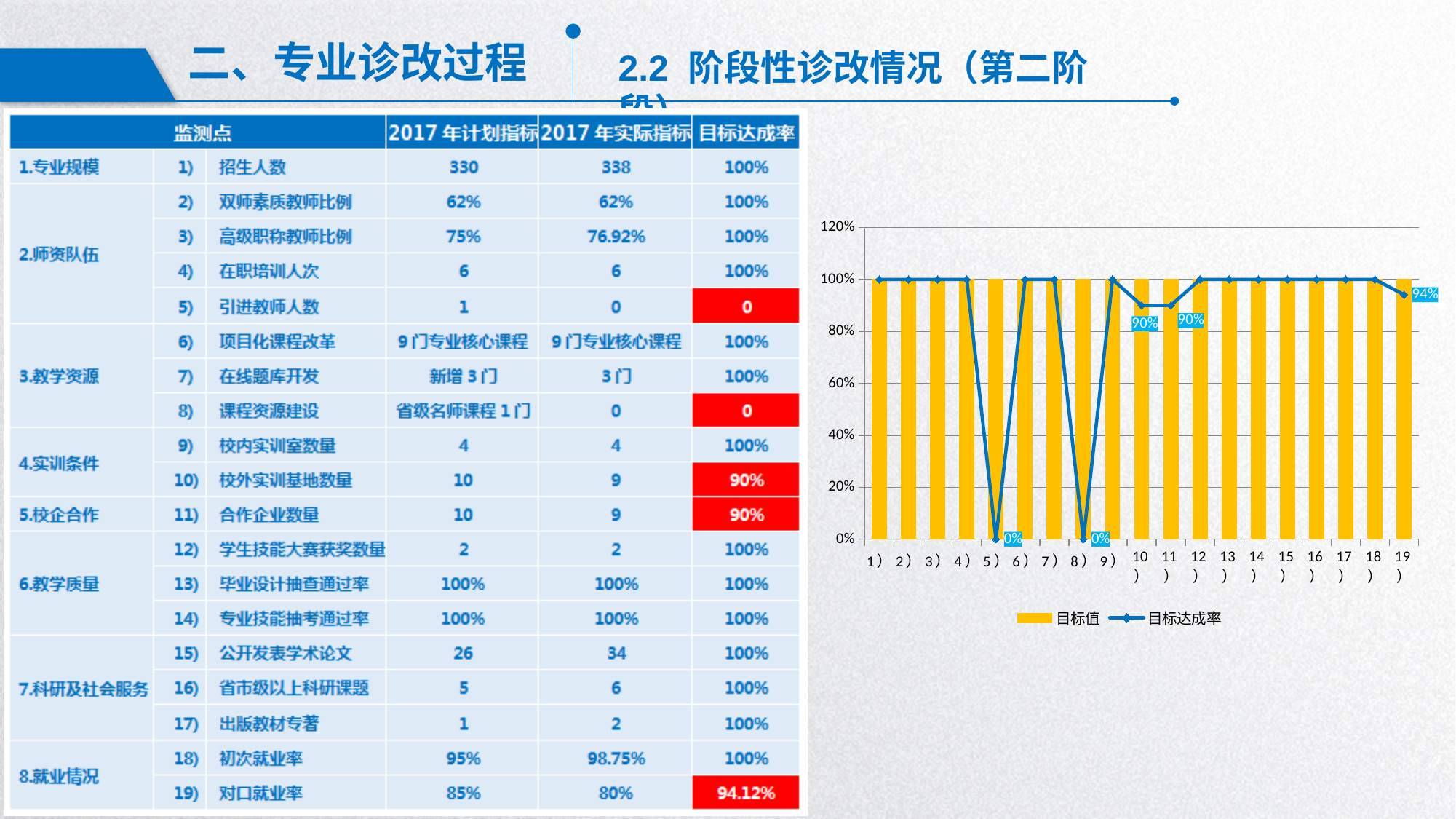
Which series in the chart is drawn as yellow bars? 目标值 What is the difference between the 目标达成率 for category 19) and for category 10)? 4% What is the 目标达成率 value for category 19) in the chart? 94% What is the 目标达成率 value for category 8) in the chart? 0% How many categories are shown on the x axis of the chart? 19 What is the 目标达成率 value for category 10) in the chart? 90% How many series does the chart legend list? 2 What kind of chart is shown on the right of the slide? Combined bar and line chart What is the 目标达成率 value for category 5) in the chart? 0% Which is larger in the chart, the 目标达成率 for category 11) or for category 19)? 19) Is the 目标值 bar for category 6) greater or less than 60%? greater Is the 目标达成率 value for category 12) greater or less than 80%? greater